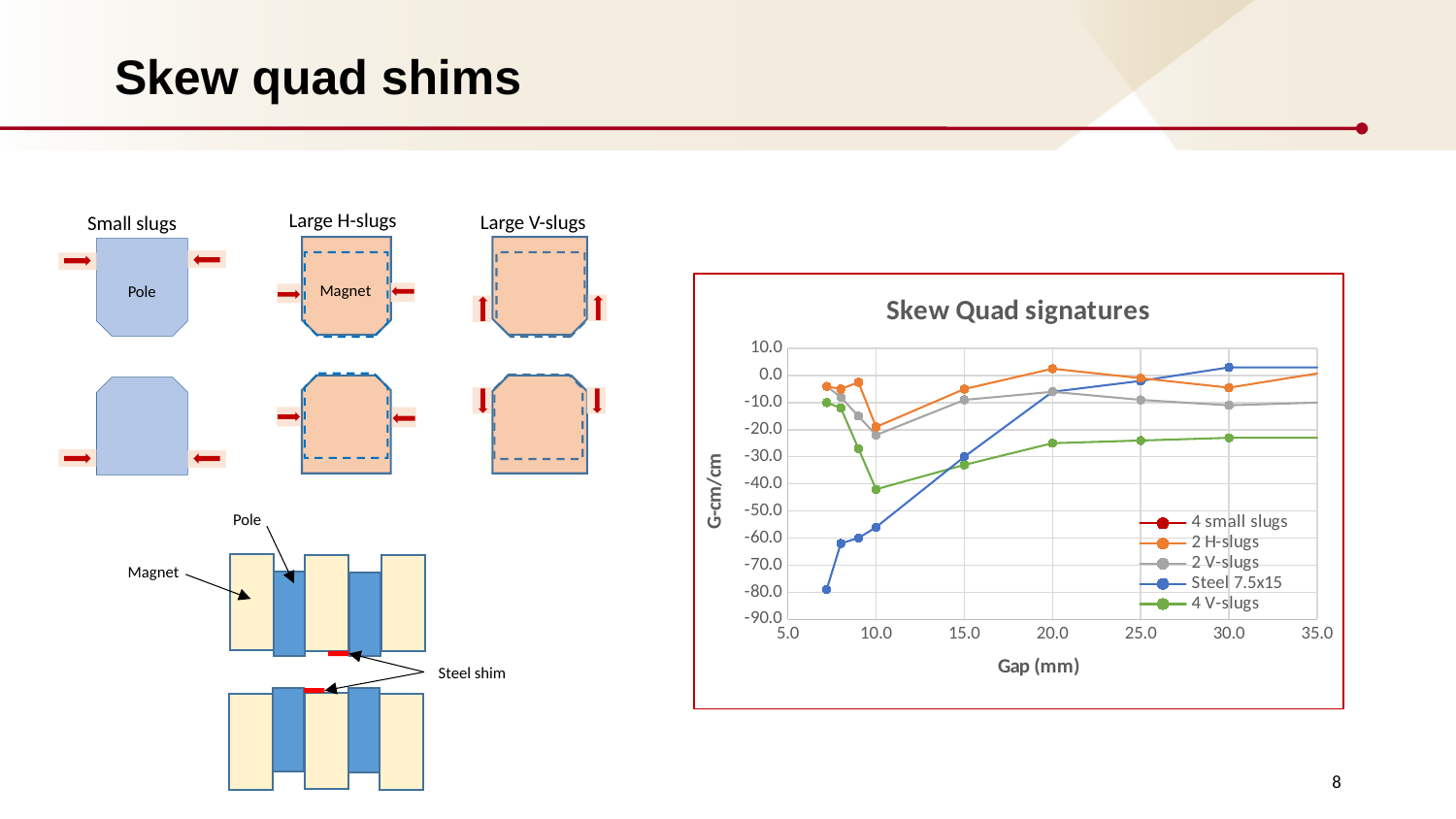
In the Skew Quad signatures chart, is the lowest value of the Steel 7.5x15 series greater or less than -70.0? less In the Skew Quad signatures chart, is the value of the 4 V-slugs series at a gap of 30.0 mm greater or less than -30.0? greater In the Skew Quad signatures chart, at a gap of 20.0 mm, which series has the higher value: 2 H-slugs or 4 V-slugs? 2 H-slugs In the Skew Quad signatures chart, is the value of the 2 H-slugs series at a gap of 20.0 mm greater or less than 0.0? greater In the Skew Quad signatures chart, which series reaches the lowest value on the chart? Steel 7.5x15 In the Skew Quad signatures chart, which series has the lowest value at a gap of 30.0 mm? 4 V-slugs What kind of chart is the Skew Quad signatures chart? line chart In the Skew Quad signatures chart, does the Steel 7.5x15 series rise or fall as the gap increases? rise In the Skew Quad signatures chart, at a gap of 10.0 mm, which series has the higher value: Steel 7.5x15 or 4 V-slugs? 4 V-slugs How many series does the legend of the Skew Quad signatures chart list? 5 What is the title of the chart on the slide? Skew Quad signatures What is the label of the y axis on the Skew Quad signatures chart? G-cm/cm